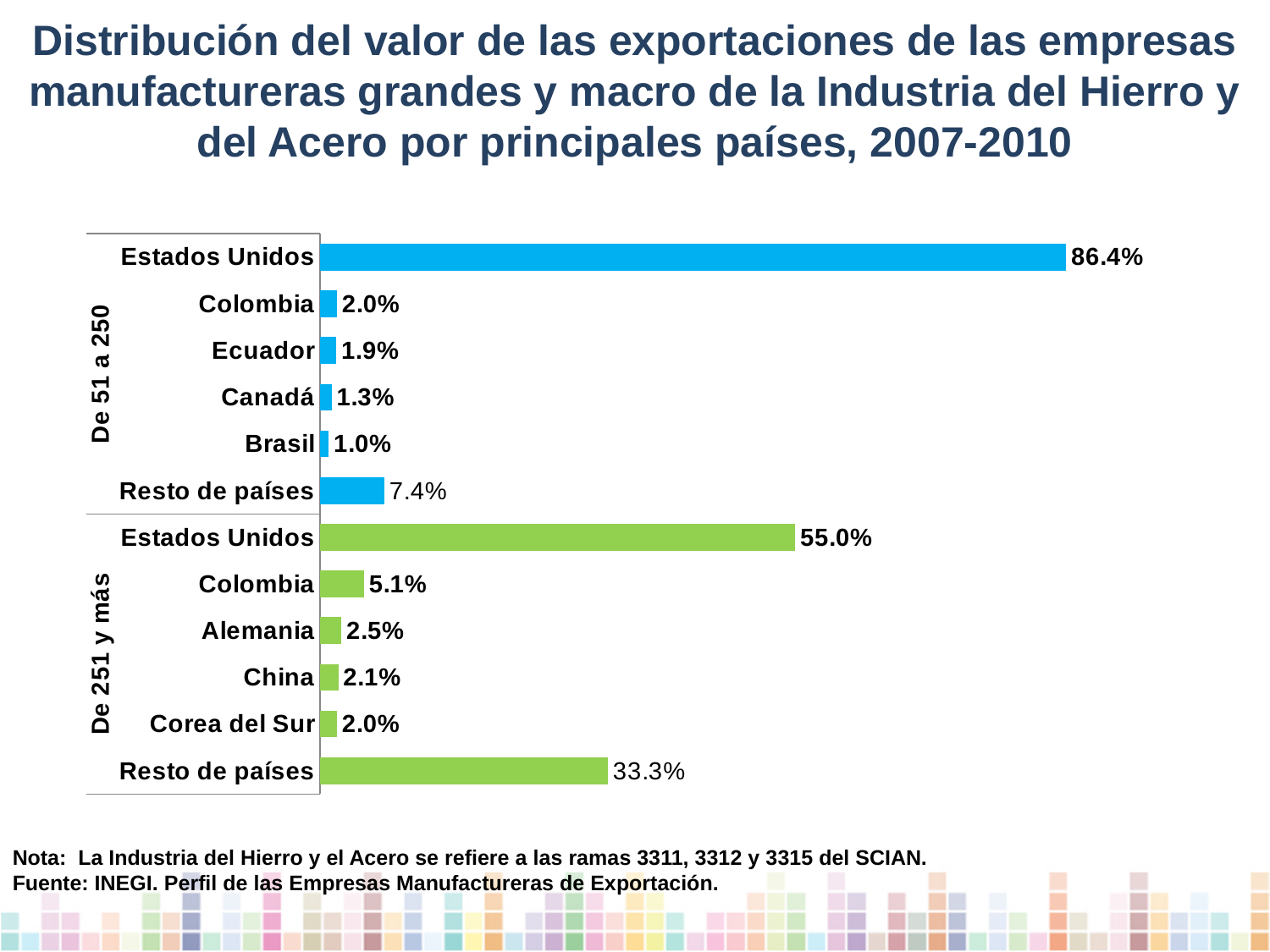
What is the value for Resto de países in the 'De 251 y más' group? 33.3% How many bars are plotted in the chart in total? 12 What is the difference between the Estados Unidos values in the 'De 51 a 250' and 'De 251 y más' groups? 31.4 percentage points What kind of chart is shown on the slide? Bar chart What is the value for Canadá in the 'De 51 a 250' group? 1.3% Which is larger: Colombia in the 'De 51 a 250' group or Colombia in the 'De 251 y más' group? Colombia in the 'De 251 y más' group Which category has the highest value in the 'De 251 y más' group? Estados Unidos What is the value for Estados Unidos in the 'De 251 y más' group? 55.0% Which country has the lowest value in the 'De 51 a 250' group? Brasil What colour are the bars for the 'De 251 y más' group? Green What is the difference between Resto de países in the 'De 251 y más' group and Resto de países in the 'De 51 a 250' group? 25.9 percentage points What is the value for Estados Unidos in the 'De 51 a 250' group? 86.4%